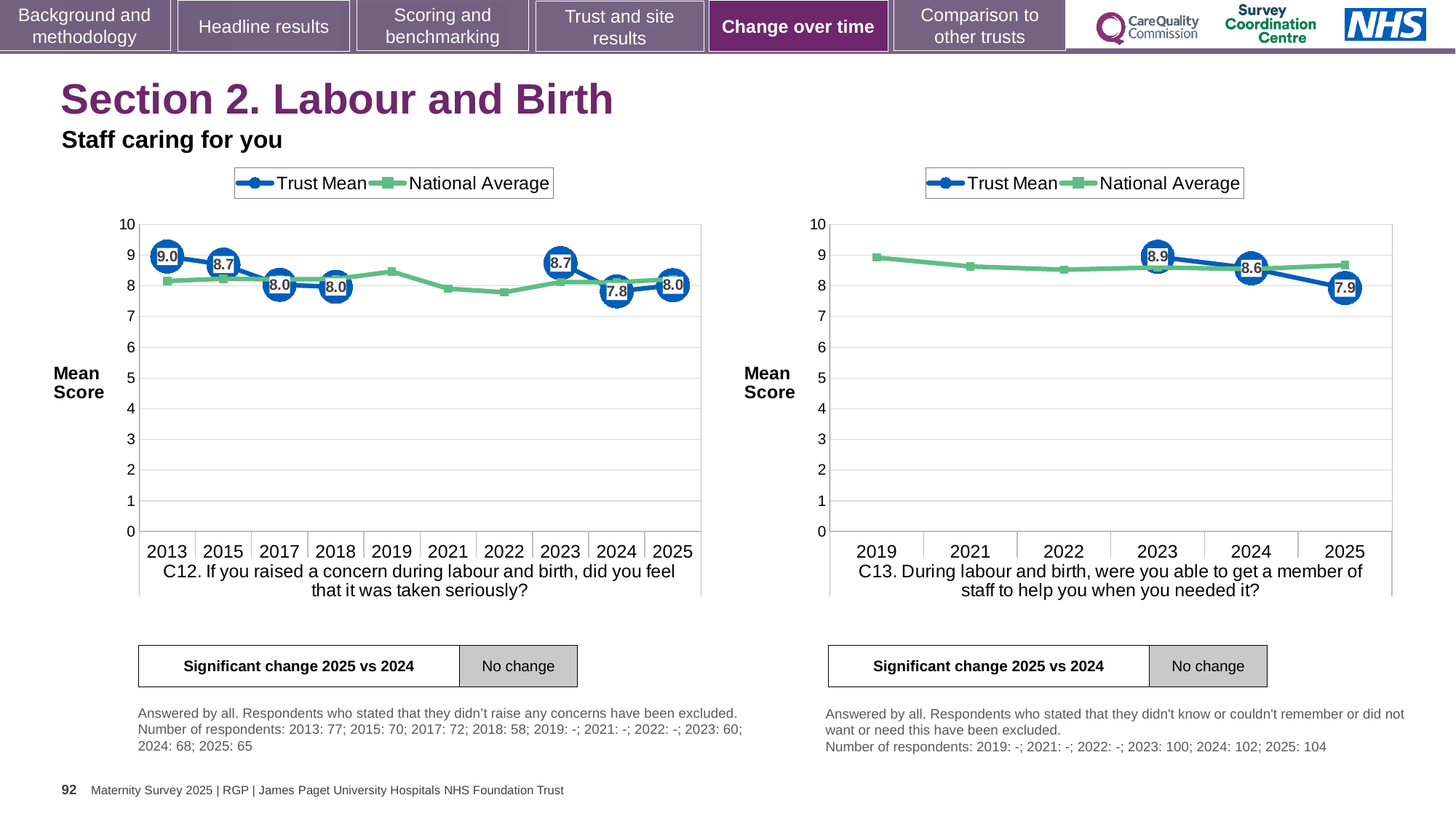
In the C13 chart (right), what is the Trust Mean for 2023? 8.9 In the C12 chart (left), is the Trust Mean higher in 2015 or in 2017? 2015 In the C12 chart (left), what is the Trust Mean for 2024? 7.8 In the C12 chart (left), which year has the highest Trust Mean? 2013 In the C12 chart (left), what is the Trust Mean for 2013? 9.0 In the C13 chart (right), what is the difference between the Trust Mean in 2023 and in 2025? 1.0 In the C13 chart (right), is the National Average for 2025 greater or less than 8? greater In the C13 chart (right), what is the Trust Mean for 2025? 7.9 How many years are shown on the x axis of the C13 chart (right)? 6 How many series does the legend of the C12 chart (left) list? 2 In the C12 chart (left), which year has the lowest labelled Trust Mean? 2024 What type of chart is the C13 chart (right)? Line chart